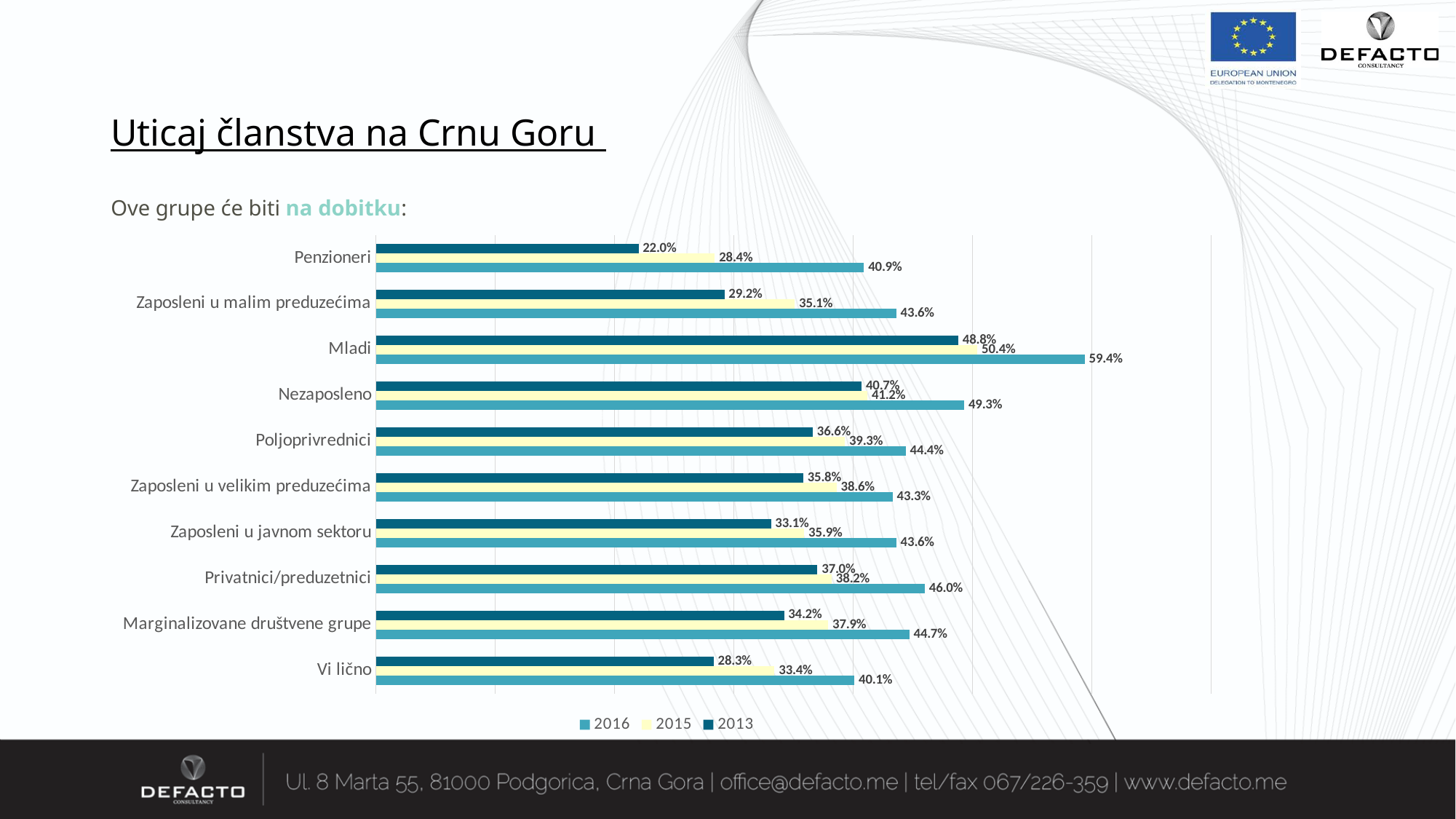
How many series does the legend list? 3 Which years are listed in the chart legend? 2016, 2015, 2013 Which category has the highest 2016 value? Mladi What is the difference between the 2016 and 2013 values for Penzioneri? 18.9% What is the 2015 value for Vi lično? 33.4% What is the 2013 value for Penzioneri? 22.0% What is the 2016 value for Mladi? 59.4% What is the 2016 value for Privatnici/preduzetnici? 46.0% Which is larger: the 2015 value for Nezaposleno or the 2015 value for Poljoprivrednici? Nezaposleno How many categories are shown on the chart? 10 Which category has the lowest 2013 value? Penzioneri What kind of chart is shown on the slide? Bar chart